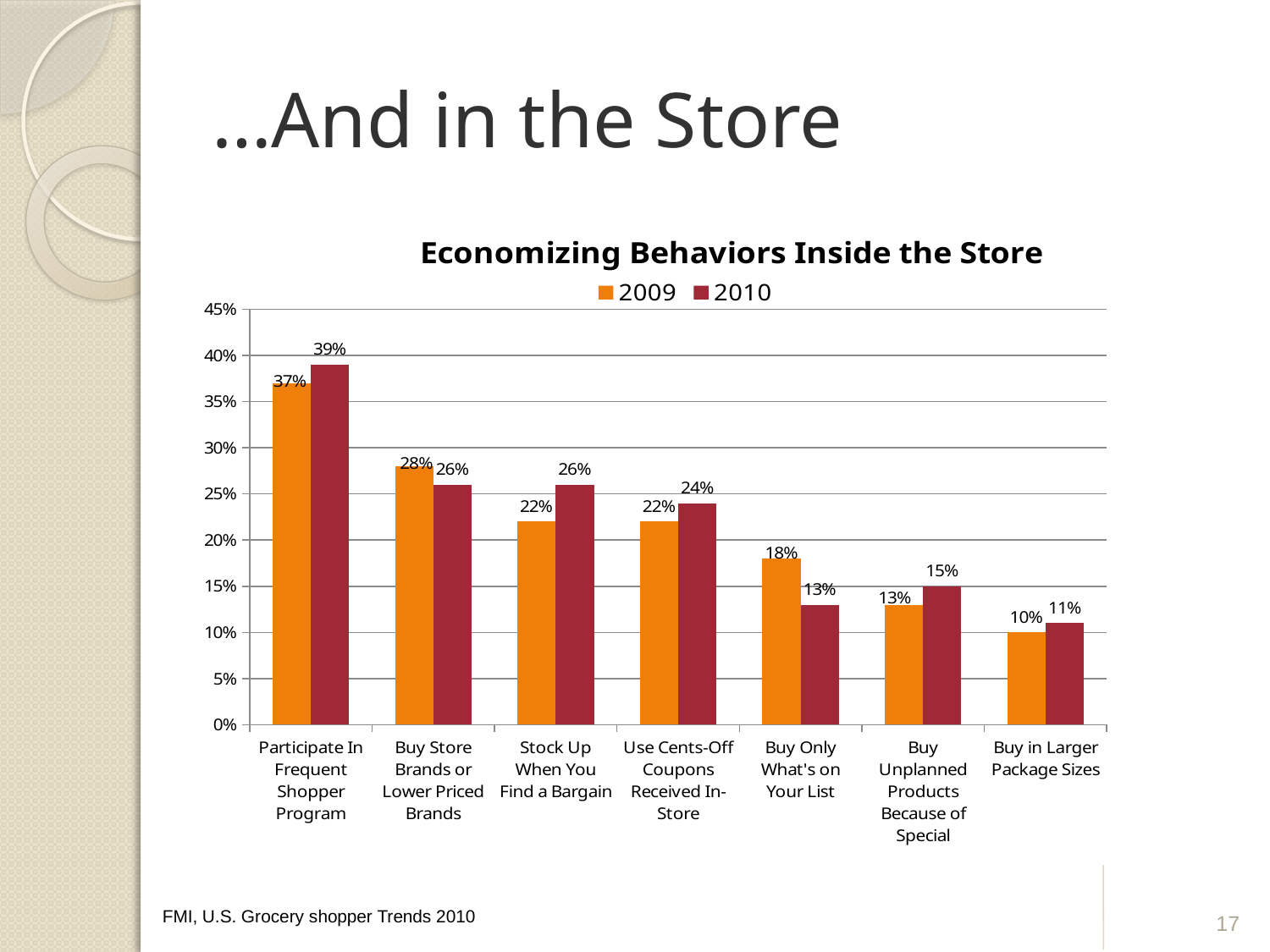
Which is larger for Buy Store Brands or Lower Priced Brands, the 2009 value or the 2010 value? 2009 What is the difference between the 2010 and 2009 values for Stock Up When You Find a Bargain? 4% What is the 2010 value for Participate In Frequent Shopper Program? 39% Which category has the highest 2009 value? Participate In Frequent Shopper Program How many categories are shown on the x axis? 7 What kind of chart is shown on the slide? Bar chart What is the 2010 value for Use Cents-Off Coupons Received In-Store? 24% How many series does the legend list? 2 What is the 2009 value for Buy Only What's on Your List? 18% Which category has the lowest 2010 value? Buy in Larger Package Sizes What is the title of the chart? Economizing Behaviors Inside the Store Do the 2009 values rise or fall from left to right along the x axis? Fall